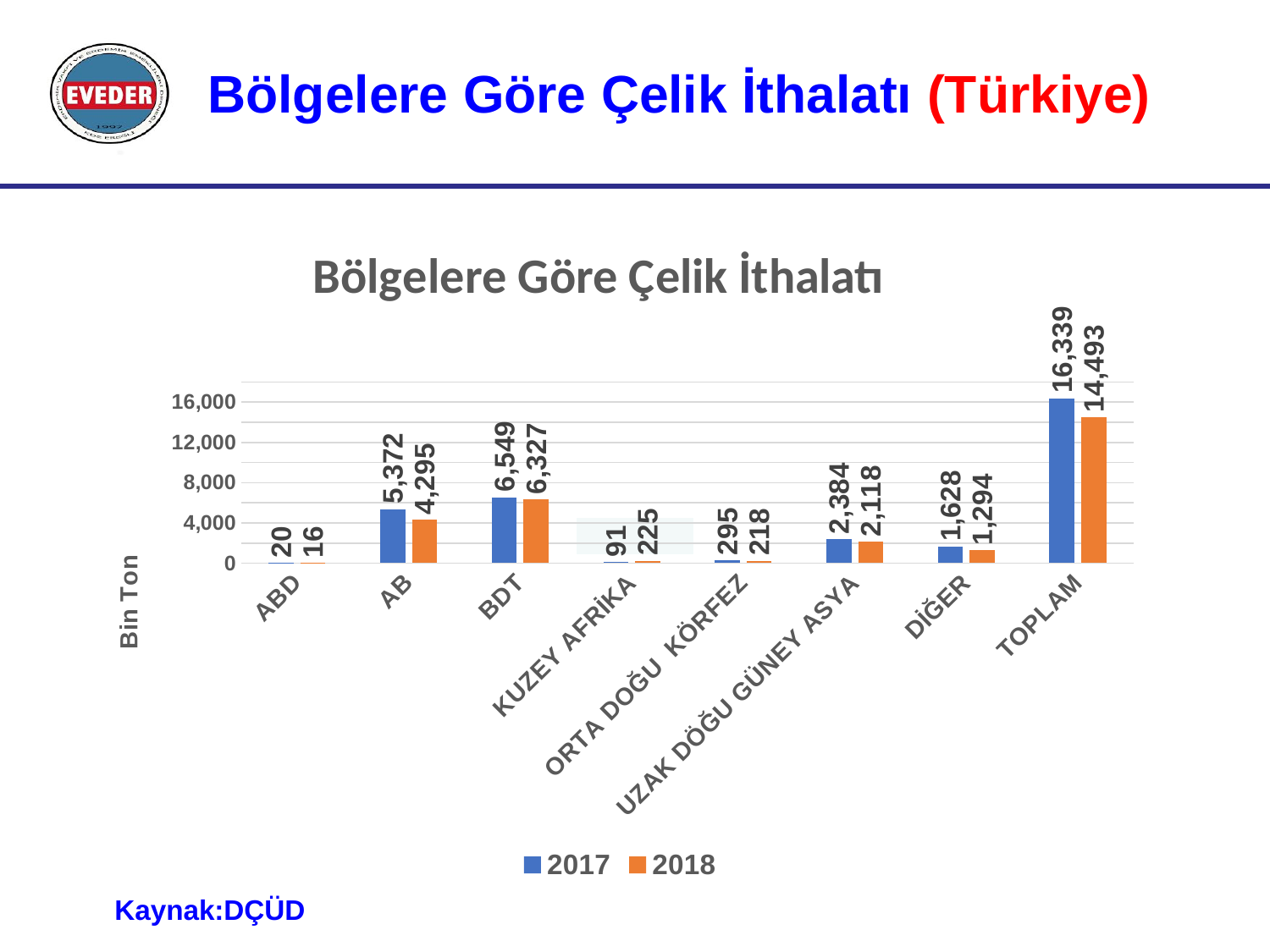
Excluding TOPLAM, which region has the highest 2018 value? BDT Which region has the lowest 2017 value? ABD What is the label on the vertical axis? Bin Ton What is the difference between the 2017 and 2018 values for TOPLAM? 1,846 How many categories are shown on the x axis? 8 What is the 2018 value for KUZEY AFRİKA? 225 Which is larger for KUZEY AFRİKA, the 2017 value or the 2018 value? 2018 What is the 2017 value for TOPLAM? 16,339 How many series does the legend list? 2 What is the 2018 value for AB? 4,295 What kind of chart is shown on the slide? Bar chart What is the 2017 value for BDT? 6,549